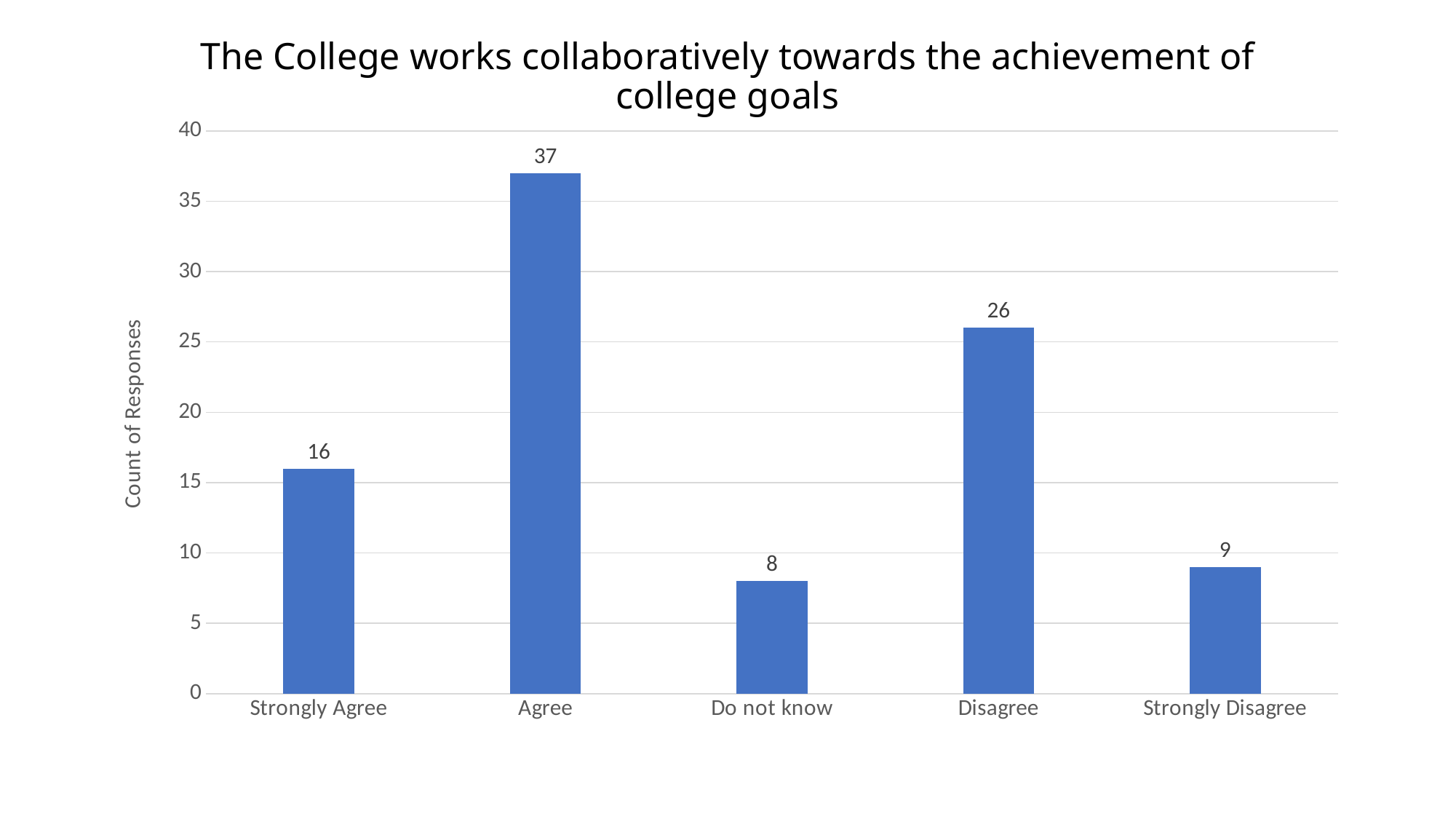
What is the count of responses for Do not know? 8 What is the difference between the counts for Strongly Agree and Strongly Disagree? 7 What is the count of responses for Strongly Disagree? 9 Which has a higher count of responses, Strongly Agree or Disagree? Disagree What kind of chart is shown on the slide? Bar chart What is the label of the vertical axis? Count of Responses Is the value for Disagree greater or less than 25? greater What is the difference between the counts for Agree and Disagree? 11 How many categories are shown on the x axis? 5 Which category has the highest count of responses? Agree What is the count of responses for Agree? 37 Which category has the lowest count of responses? Do not know